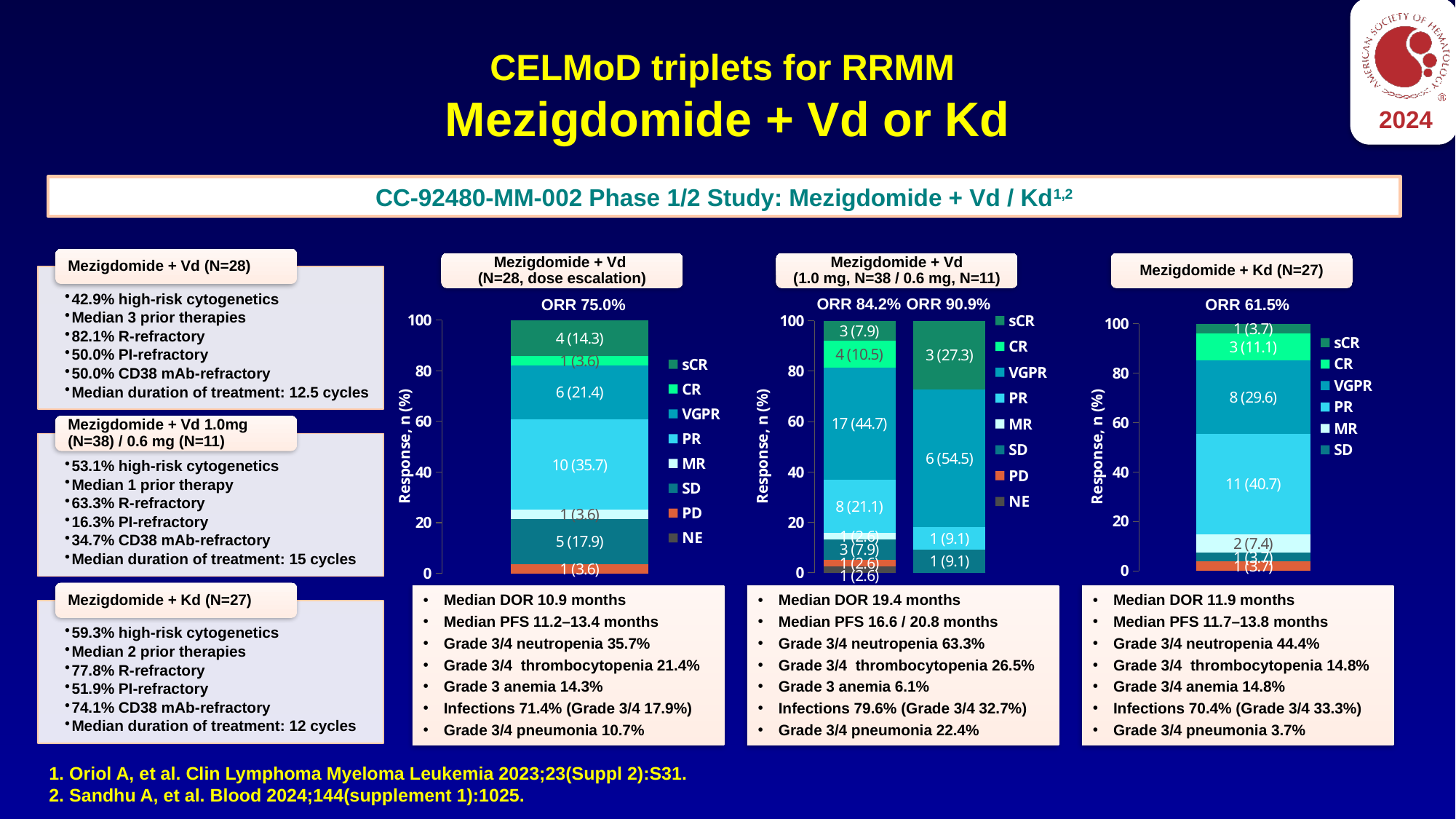
In the Mezigdomide + Vd (1.0 mg, N=38 / 0.6 mg, N=11) chart, what is the value labelled for the VGPR segment of the 1.0 mg bar? 17 (44.7) In the Mezigdomide + Kd (N=27) chart, what is the value labelled for the CR segment? 3 (11.1) In the Mezigdomide + Vd (N=28, dose escalation) chart, what is the value labelled for the SD segment? 5 (17.9) In the Mezigdomide + Vd (1.0 mg, N=38 / 0.6 mg, N=11) chart, what ORR is shown above the 0.6 mg bar? ORR 90.9% In the Mezigdomide + Kd (N=27) chart, what is the value labelled for the PR segment? 11 (40.7) In the Mezigdomide + Vd (1.0 mg, N=38 / 0.6 mg, N=11) chart, how many bars are plotted? 2 What kind of chart is the Mezigdomide + Kd (N=27) chart? Stacked bar chart In the Mezigdomide + Vd (N=28, dose escalation) chart, which response category has the largest segment? PR In the Mezigdomide + Kd (N=27) chart, which is larger, the VGPR segment or the PR segment? PR In the Mezigdomide + Vd (N=28, dose escalation) chart, what is the value labelled for the PR segment? 10 (35.7) In the Mezigdomide + Vd (1.0 mg, N=38 / 0.6 mg, N=11) chart, what is the value labelled for the VGPR segment of the 0.6 mg bar? 6 (54.5) In the Mezigdomide + Vd (N=28, dose escalation) chart, how many entries does the legend list? 8